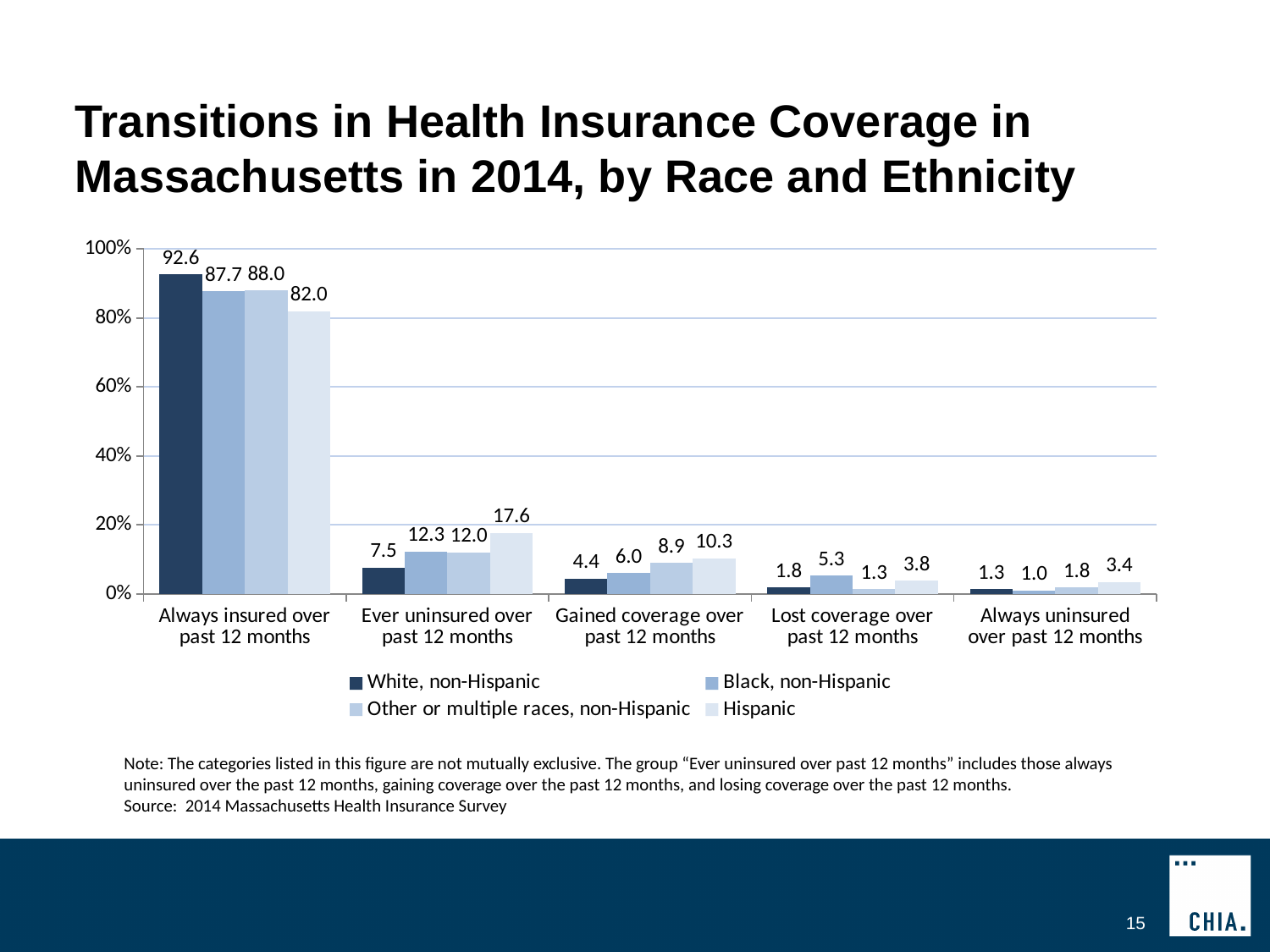
What is the source cited for the chart? 2014 Massachusetts Health Insurance Survey How many series does the legend list? 4 Is the value for Black, non-Hispanic in the 'Always insured over past 12 months' category greater or less than 80%? greater How many categories are shown on the x axis? 5 What kind of chart is shown on the slide? Bar chart In the 'Always uninsured over past 12 months' category, which is larger: the value for Black, non-Hispanic or the value for Hispanic? Hispanic Which group has the lowest value in the 'Always insured over past 12 months' category? Hispanic What is the difference between the White, non-Hispanic and Hispanic values in the 'Always insured over past 12 months' category? 10.6 What is the value for Black, non-Hispanic in the 'Lost coverage over past 12 months' category? 5.3 What is the value for White, non-Hispanic in the 'Always insured over past 12 months' category? 92.6 What is the value for Hispanic in the 'Ever uninsured over past 12 months' category? 17.6 Which group has the highest value in the 'Gained coverage over past 12 months' category? Hispanic